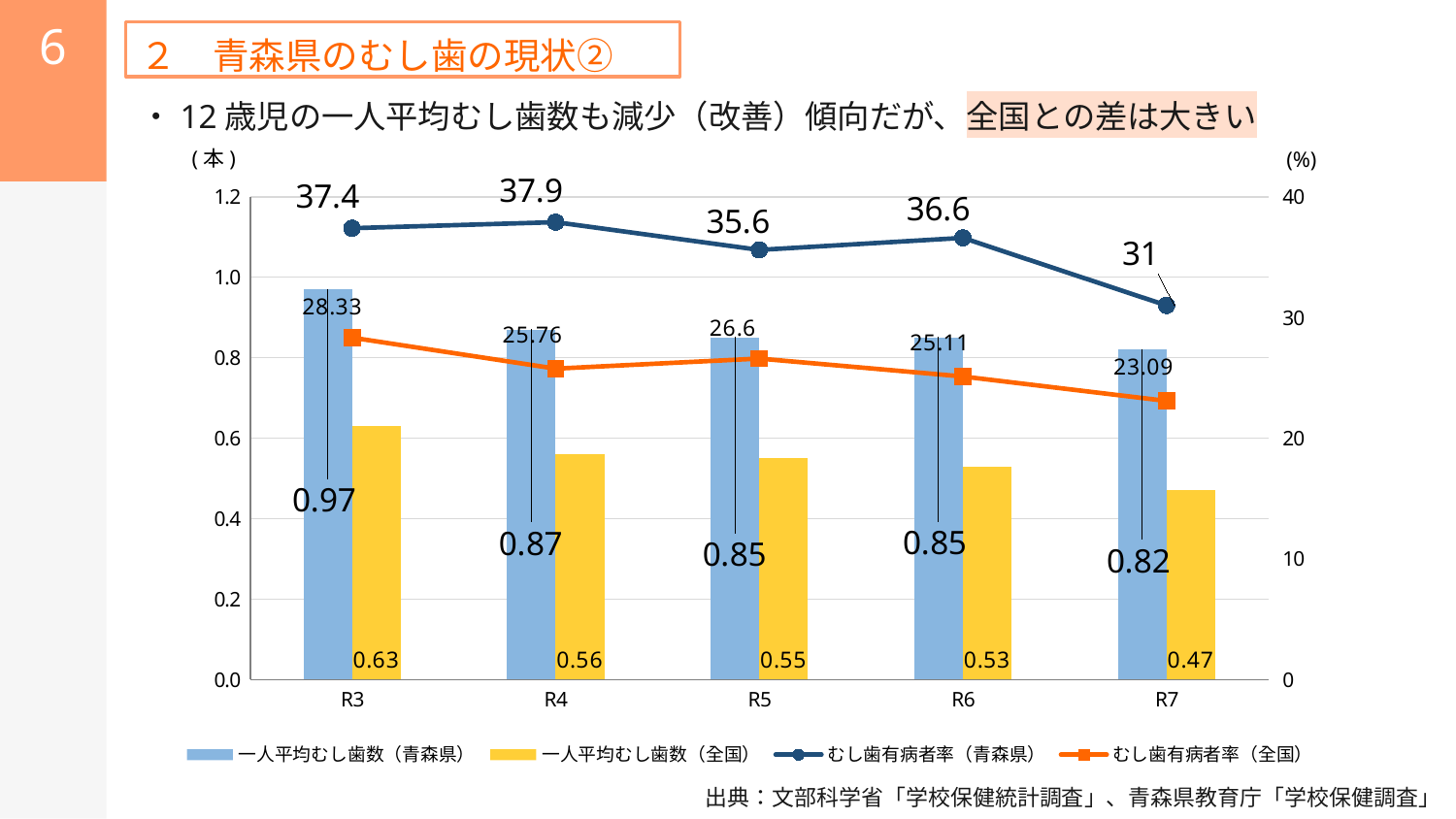
Does むし歯有病者率（全国） rise or fall from R3 to R7 overall? fall What is the value of むし歯有病者率（青森県） for R5? 35.6 What unit is shown on the right-hand vertical axis? % Which is larger in R3: むし歯有病者率（青森県） or むし歯有病者率（全国）? むし歯有病者率（青森県） What is the value of 一人平均むし歯数（全国） for R7? 0.47 How many years are shown on the x axis? 5 In which year is 一人平均むし歯数（全国） lowest? R7 What is the value of 一人平均むし歯数（青森県） for R3? 0.97 In which year is むし歯有病者率（青森県） highest? R4 What is the value of むし歯有病者率（全国） for R4? 25.76 How many series does the legend list? 4 What is the difference between 一人平均むし歯数（青森県） and 一人平均むし歯数（全国） in R7? 0.35